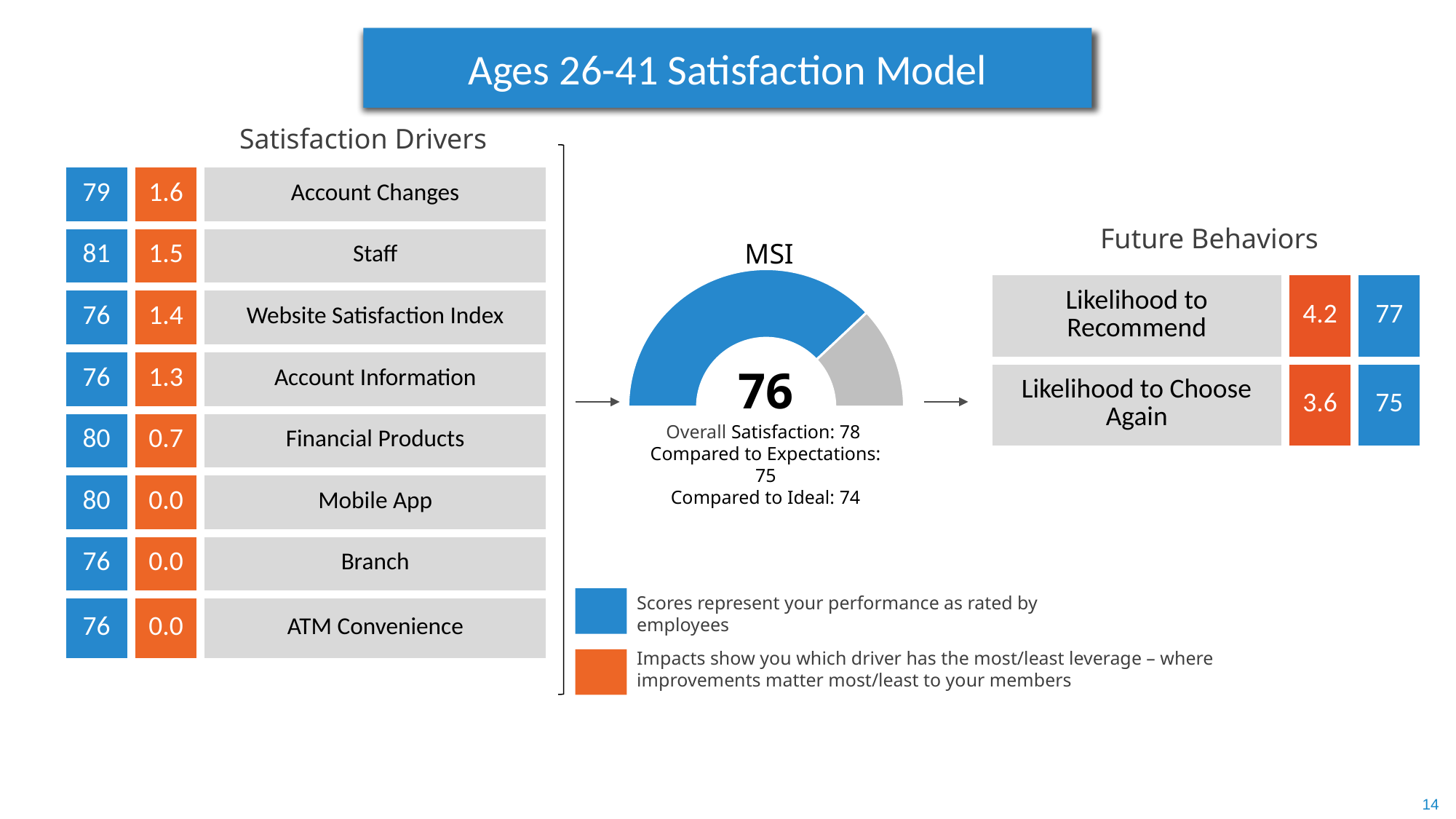
What is the title of the gauge chart in the centre of the slide? MSI What colour is the filled portion of the MSI gauge chart? blue What value does the MSI gauge chart display? 76 What is the Compared to Ideal value printed below the MSI gauge? 74 What kind of chart is the MSI chart in the centre of the slide? gauge chart What is the Overall Satisfaction value printed below the MSI gauge? 78 In the Satisfaction Drivers list, which driver has the highest orange impact value? Account Changes In the Satisfaction Drivers list, which driver has the highest blue score? Staff What is the difference between the Overall Satisfaction value (78) and the Compared to Ideal value (74) printed below the MSI gauge? 4 How many satisfaction drivers are listed on the slide? 8 Is the value shown on the MSI gauge chart greater or less than 50? greater Which is larger, the Overall Satisfaction value or the Compared to Expectations value printed below the MSI gauge? Overall Satisfaction